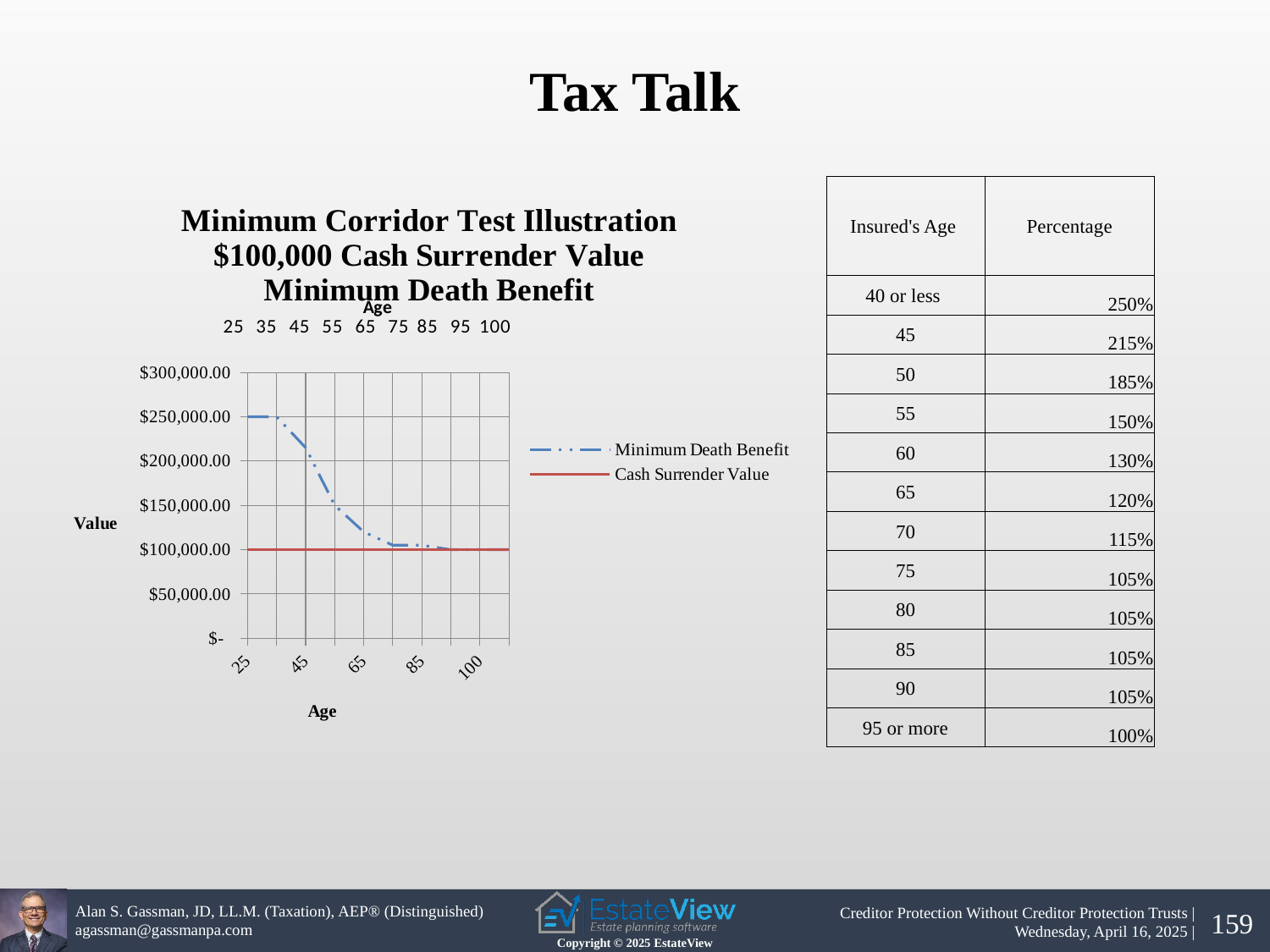
Is the Minimum Death Benefit at age 45 greater or less than $200,000.00? greater What kind of chart is shown on the slide? line chart Is the Minimum Death Benefit at age 65 greater or less than $100,000.00? greater What is the value of the Cash Surrender Value line across all ages? $100,000.00 Does the Minimum Death Benefit rise or fall as age increases along the x axis? fall Is the Minimum Death Benefit at age 65 greater or less than $150,000.00? less At age 45, which series has the higher value, Minimum Death Benefit or Cash Surrender Value? Minimum Death Benefit What is the Minimum Death Benefit at age 25? $250,000.00 What are the two series named in the chart's legend? Minimum Death Benefit and Cash Surrender Value How many series does the chart's legend list? 2 What is the highest value shown on the chart's vertical axis? $300,000.00 What is the label on the chart's vertical axis? Value